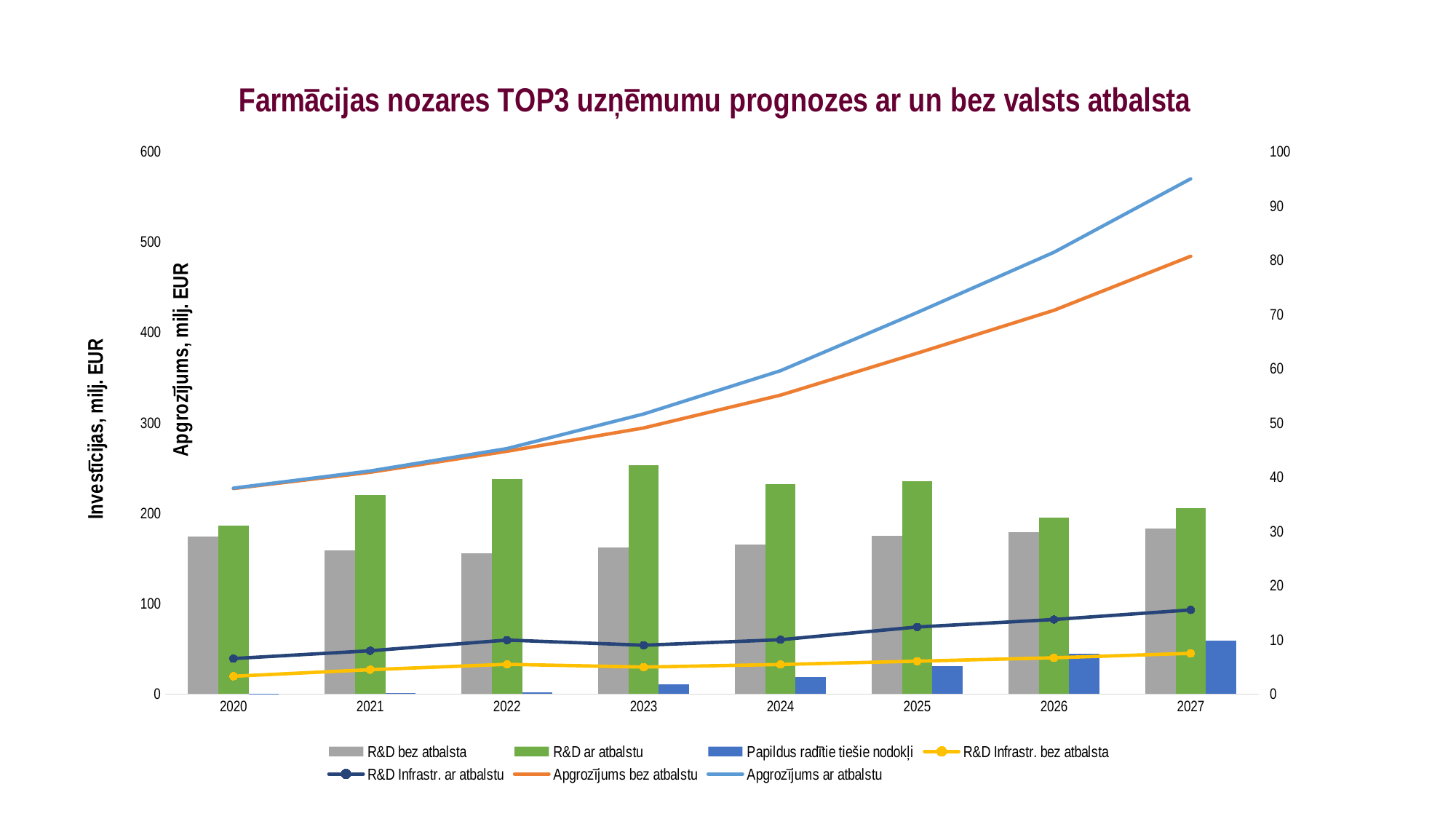
What colour are the R&D ar atbalstu bars? Green Which is larger in 2027: Apgrozījums ar atbalstu or Apgrozījums bez atbalstu? Apgrozījums ar atbalstu In which year is the Papildus radītie tiešie nodokļi bar the highest? 2027 How many series does the chart legend list? 7 On the right axis, is the value for Apgrozījums ar atbalstu in 2027 greater or less than 90? greater What is the title of the chart? Farmācijas nozares TOP3 uzņēmumu prognozes ar un bez valsts atbalsta What kind of chart is this? Combined bar and line chart In which year is the R&D ar atbalstu bar the highest? 2023 Is the value for R&D bez atbalsta in 2020 greater or less than 200? less How many years are shown on the x axis of the chart? 8 Does the Apgrozījums ar atbalstu line rise or fall from 2020 to 2027? rise